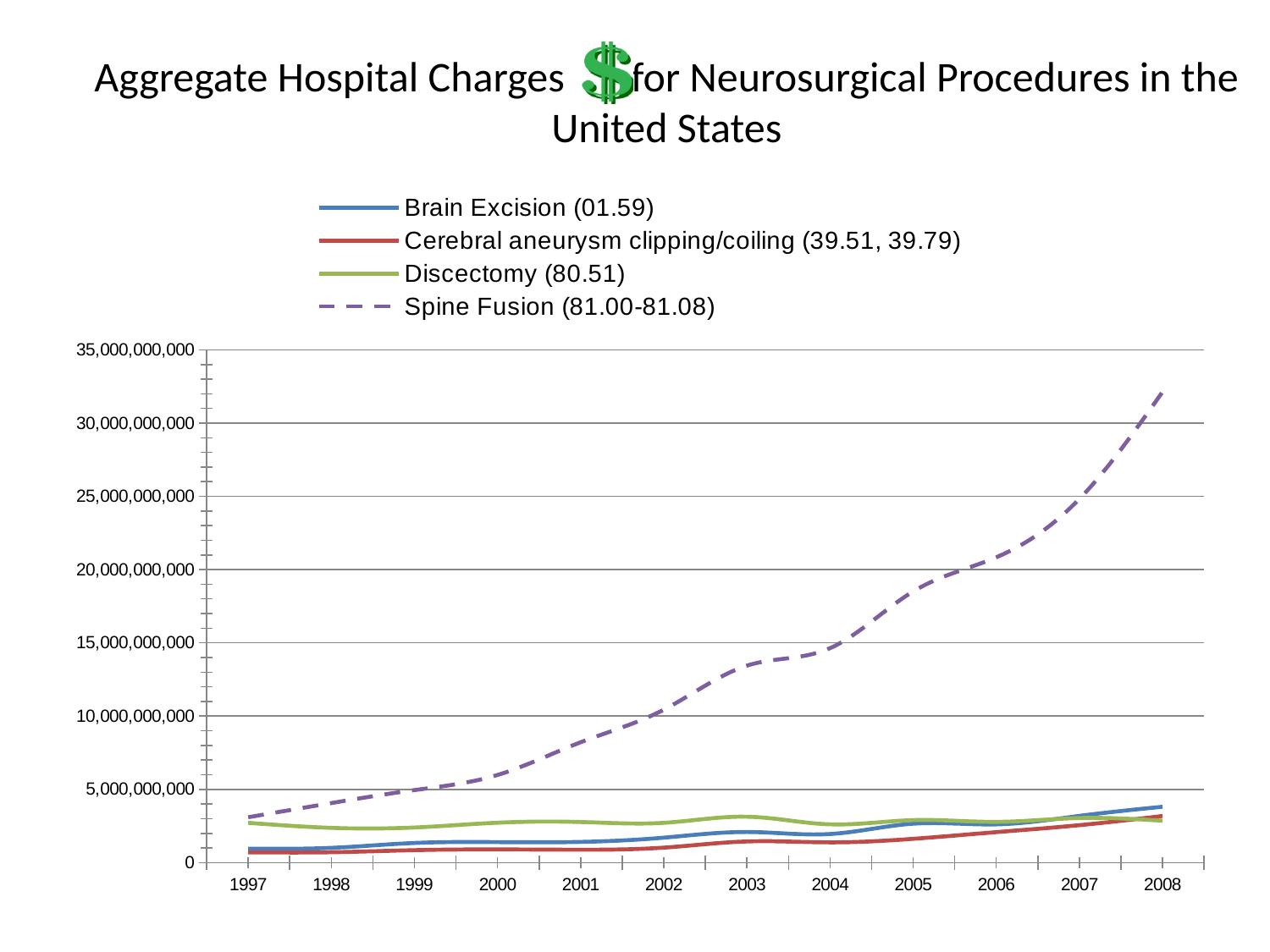
In 2008, which is larger: the value for Spine Fusion or the value for Discectomy? Spine Fusion Is the value for Brain Excision in 2008 greater or less than 5,000,000,000? less Which procedure has the lowest aggregate hospital charges in 1997? Cerebral aneurysm clipping/coiling (39.51, 39.79) In 1997, which is larger: the value for Discectomy or the value for Cerebral aneurysm clipping/coiling? Discectomy How many years are plotted along the x axis? 12 Is the value for Spine Fusion in 2008 greater or less than 30,000,000,000? greater Which series is drawn with a dashed line? Spine Fusion (81.00-81.08) How many series does the legend list? 4 Which procedure has the highest aggregate hospital charges in 2008? Spine Fusion (81.00-81.08) Do the aggregate charges for Spine Fusion rise or fall from 1997 to 2008? rise Is the value for Spine Fusion in 1997 greater or less than 5,000,000,000? less What kind of chart is shown on the slide? line chart